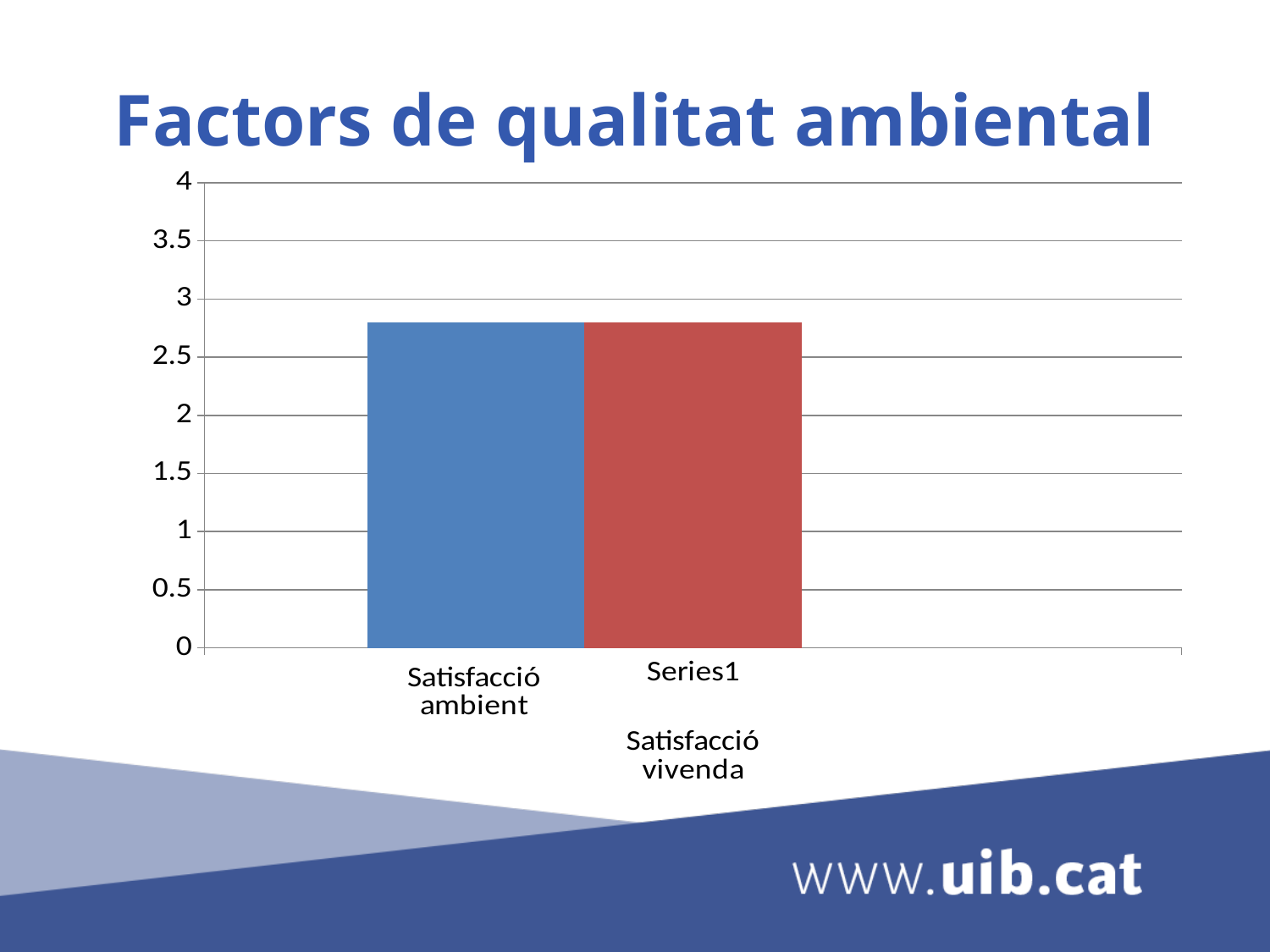
What kind of chart is shown on the slide? bar chart Is the value for Satisfacció ambient greater or less than 3.5? less Is the value for Satisfacció ambient greater or less than 3? less Is the value for Satisfacció vivenda greater or less than 3? less How many bars are plotted in the chart? 2 What is the title of the chart? Factors de qualitat ambiental What is the maximum value shown on the vertical axis? 4